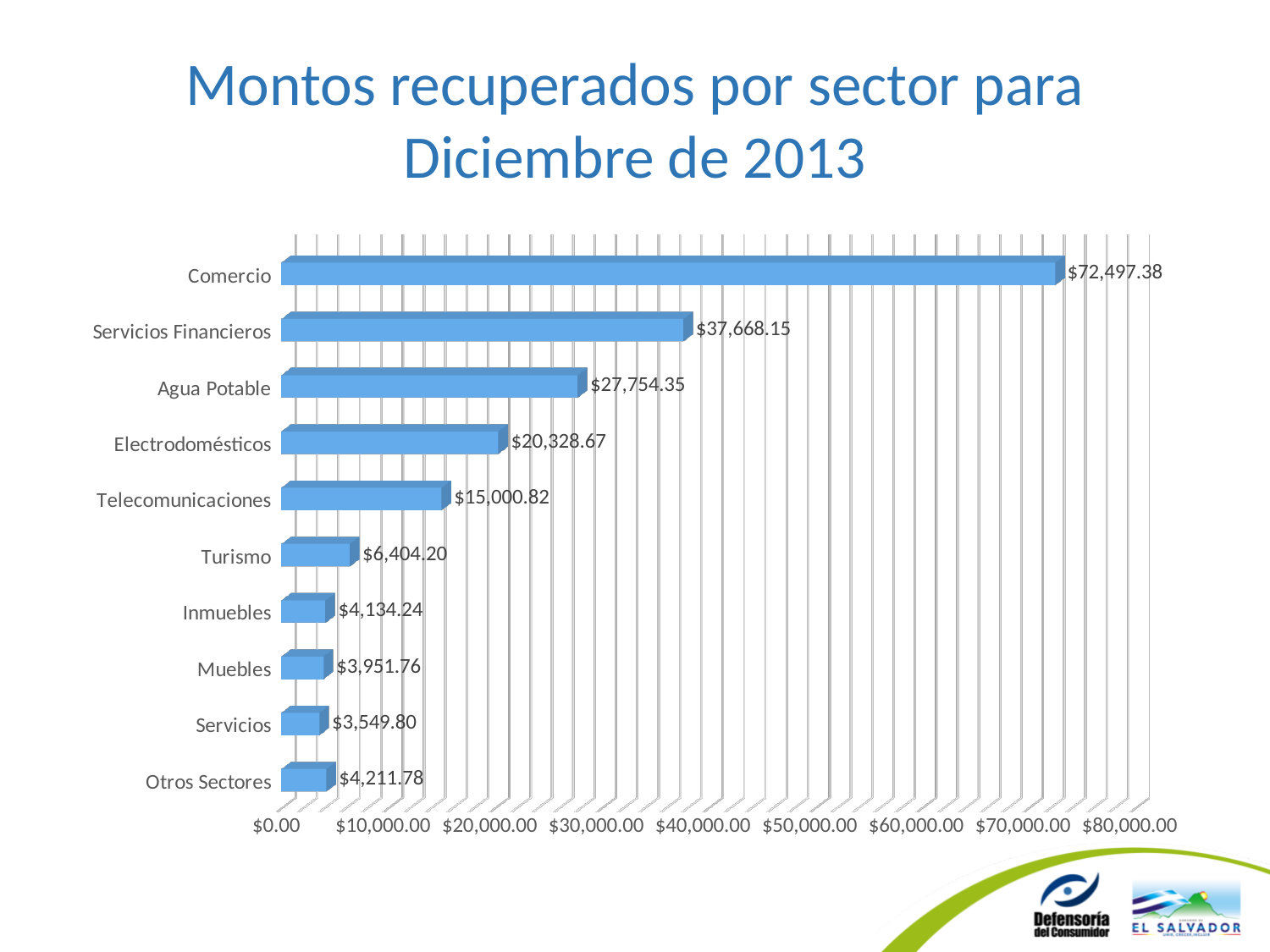
Which sector has the highest recovered amount? Comercio What is the difference between the values for Agua Potable and Electrodomésticos? $7,425.68 Is the value for Servicios Financieros greater or less than $40,000.00? less What is the value for Otros Sectores? $4,211.78 What kind of chart is shown on the slide? bar chart What is the difference between the values for Comercio and Servicios Financieros? $34,829.23 What is the title of the slide? Montos recuperados por sector para Diciembre de 2013 What is the value for Comercio? $72,497.38 Which sector has the lowest recovered amount? Servicios What is the value for Telecomunicaciones? $15,000.82 How many sectors are shown in the chart? 10 Which is larger, the value for Turismo or the value for Inmuebles? Turismo